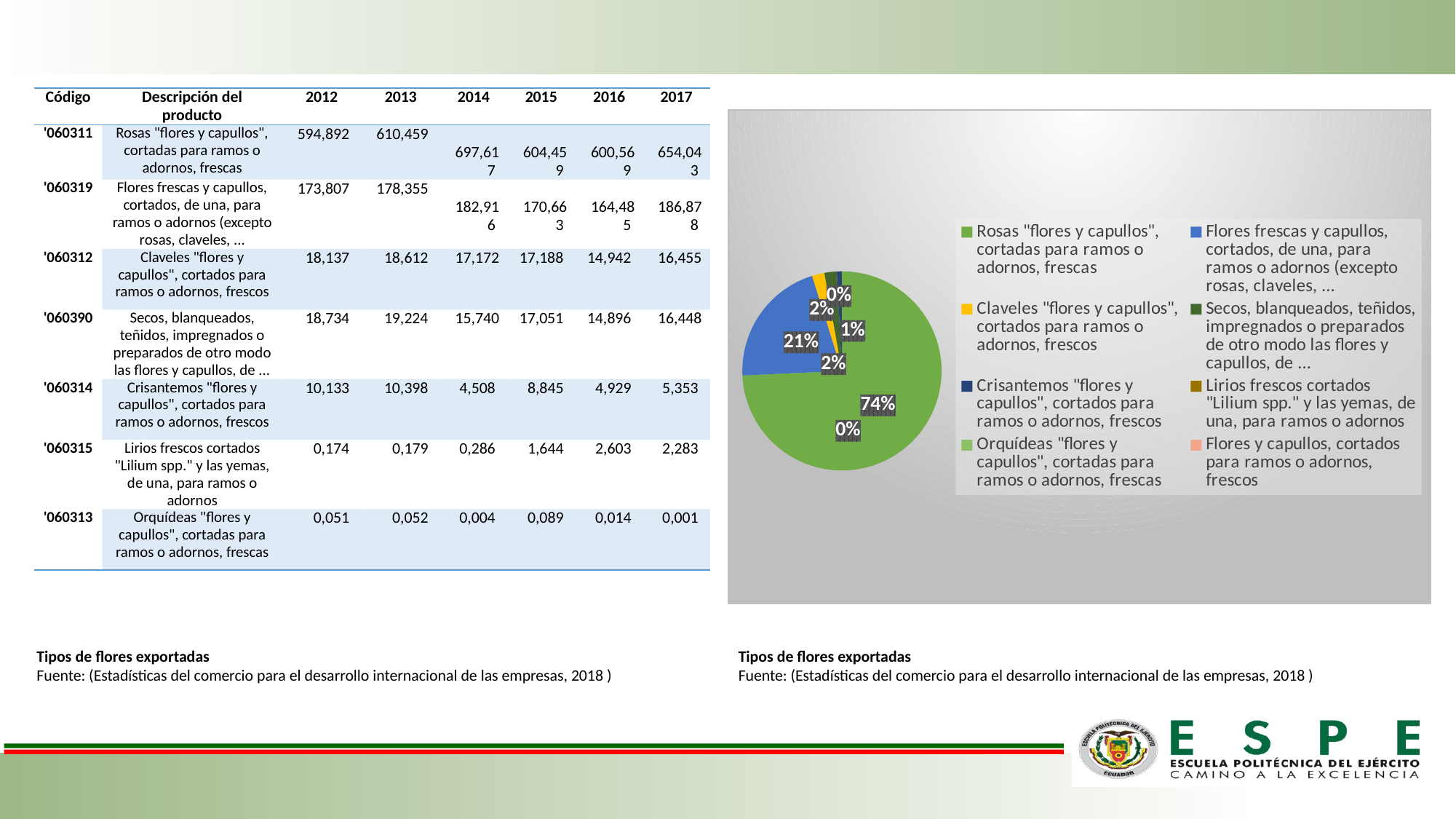
In the pie chart, what share is shown for Crisantemos "flores y capullos", cortados para ramos o adornos, frescos? 1% In the pie chart, which is larger: the share for Rosas or the share for Flores frescas y capullos (excepto rosas, claveles, ...)? Rosas In the pie chart, what share is shown for Rosas "flores y capullos", cortadas para ramos o adornos, frescas? 74% What kind of chart is shown on the right side of the slide? pie chart What is the caption given below the pie chart? Tipos de flores exportadas In the pie chart, which category has the largest share? Rosas "flores y capullos", cortadas para ramos o adornos, frescas In the pie chart, what share is shown for Claveles "flores y capullos", cortados para ramos o adornos, frescos? 2% In the pie chart, what is the difference in percentage points between the share for Rosas and the share for Flores frescas y capullos (excepto rosas, claveles, ...)? 53 percentage points What colour is the slice for Rosas "flores y capullos", cortadas para ramos o adornos, frescas in the pie chart? green How many entries does the legend of the pie chart list? 8